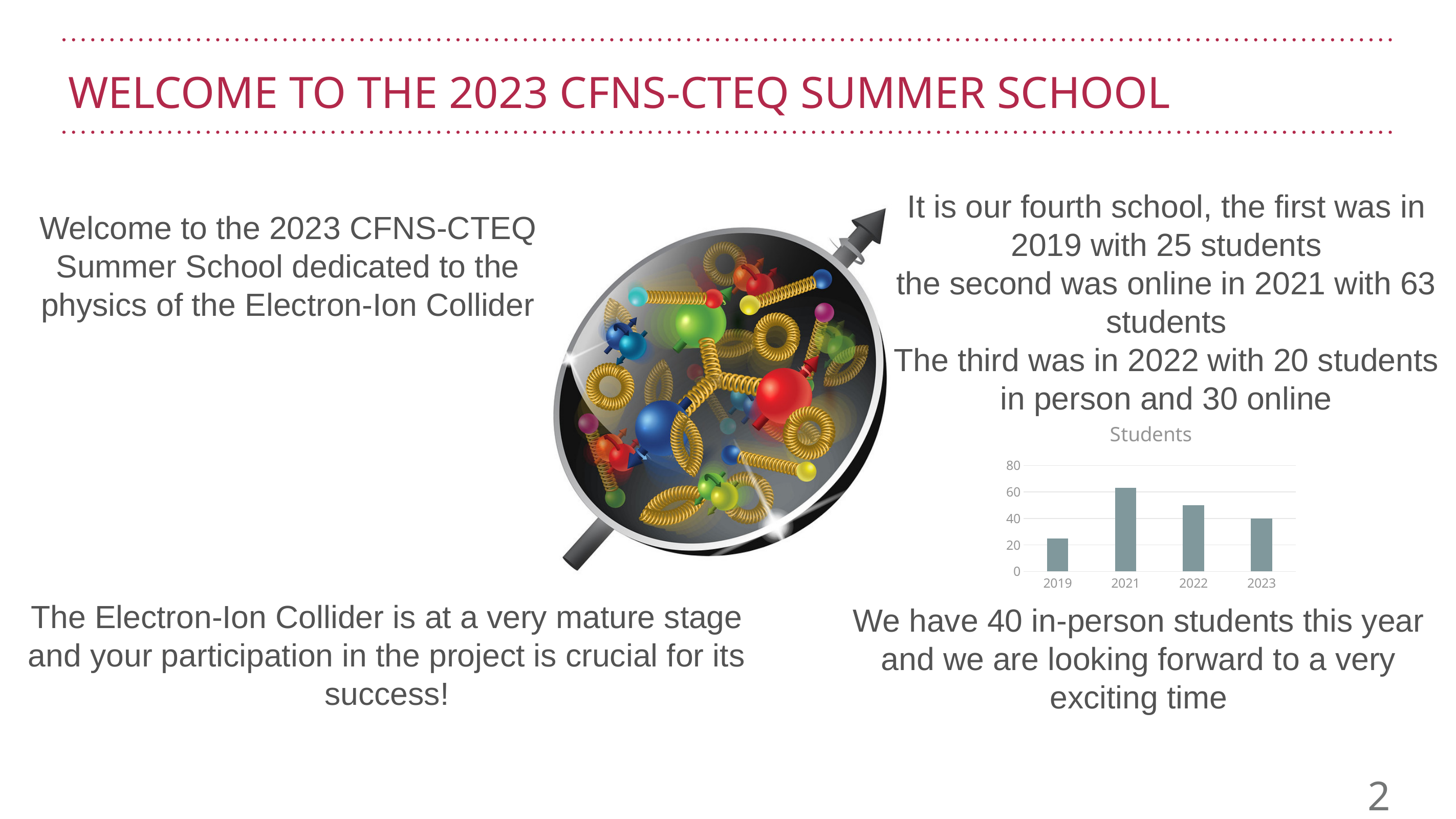
What is the value for 2023 in the Students chart? 40 Is the value for 2022 greater or less than 40? greater Is the value for 2019 greater or less than 20? greater Which is larger in the Students chart, the value for 2021 or the value for 2022? 2021 Which year has the lowest bar in the Students chart? 2019 Is the value for 2022 greater or less than 60? less What is the title of the chart? Students Which year has the highest bar in the Students chart? 2021 What type of chart is shown on the slide? bar chart Do the values in the Students chart rise or fall from 2021 to 2023? fall How many years are shown on the x axis of the Students chart? 4